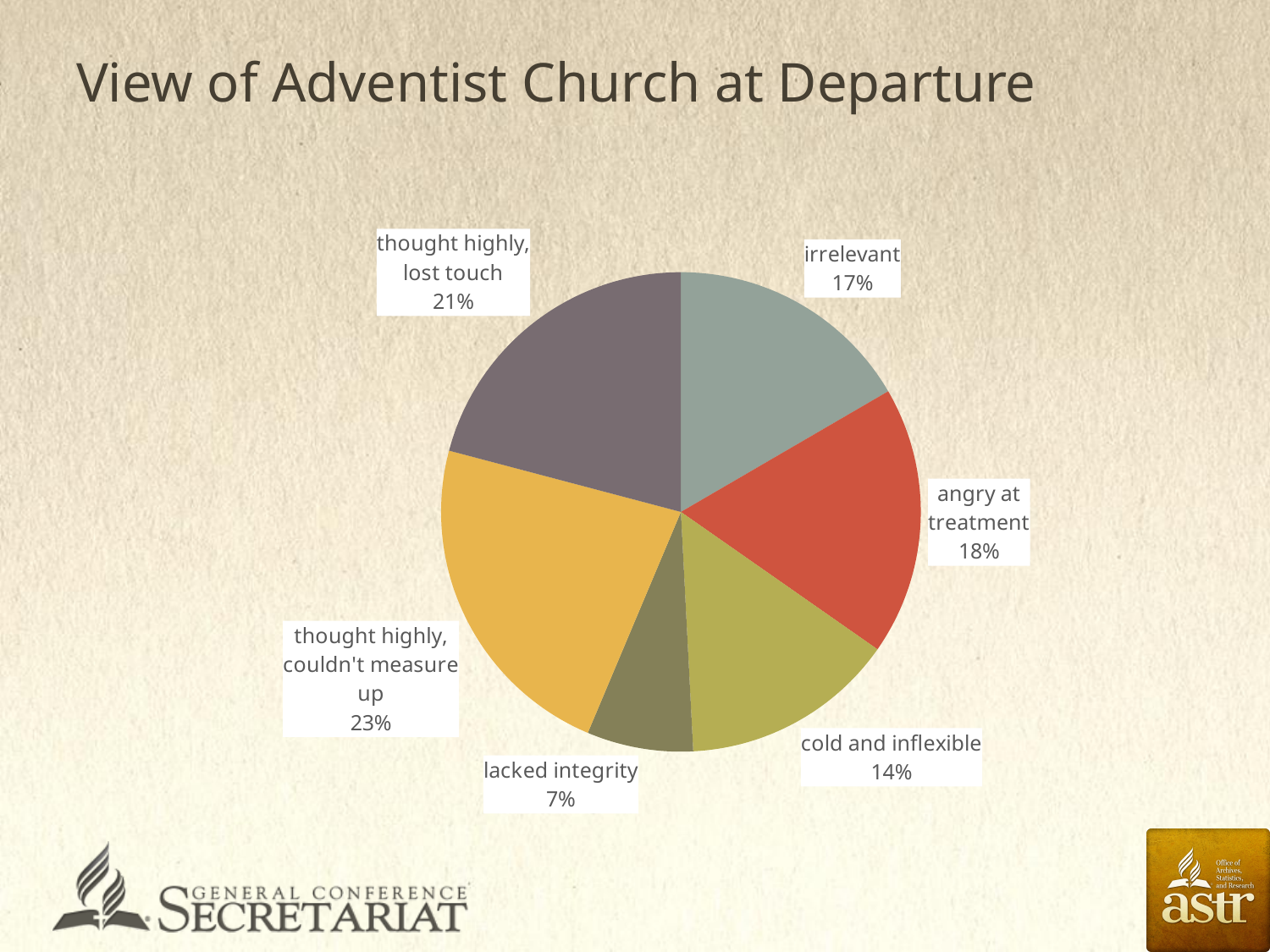
What share does the "angry at treatment" slice have? 18% What percentage is shown for "cold and inflexible"? 14% What percentage of the pie is labelled "irrelevant"? 17% What is the combined percentage of the two "thought highly" slices? 44% What is the value shown for "lacked integrity"? 7% Which is larger: the "cold and inflexible" slice or the "irrelevant" slice? irrelevant What type of chart is shown on the slide? pie chart How many slices does the pie chart have? 6 Which category has the largest slice of the pie? thought highly, couldn't measure up What is the title of the slide? View of Adventist Church at Departure Which category has the smallest slice of the pie? lacked integrity What is the difference in percentage points between "thought highly, couldn't measure up" and "thought highly, lost touch"? 2